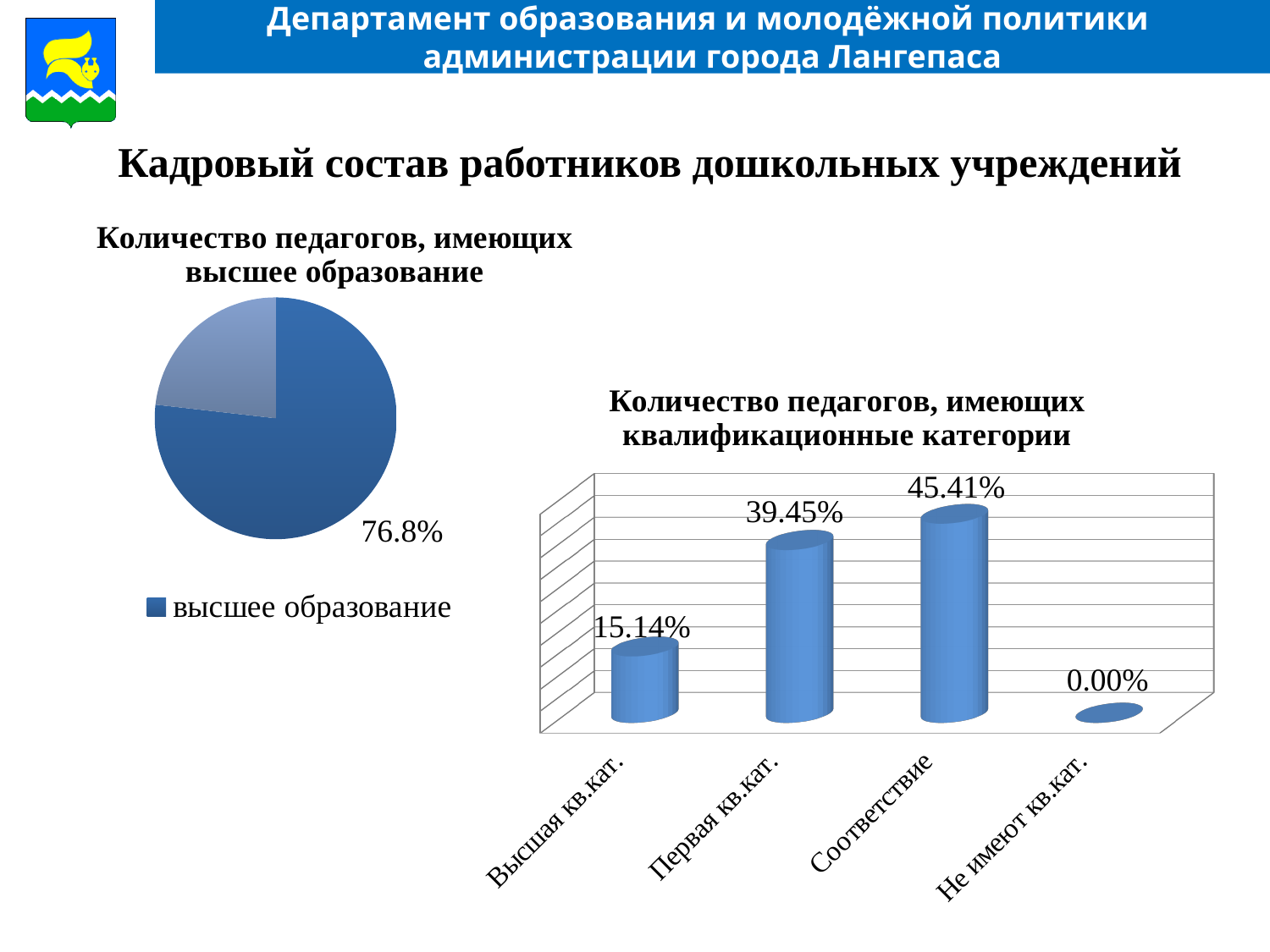
In the chart titled "Количество педагогов, имеющих квалификационные категории", which is larger: "Высшая кв.кат." or "Первая кв.кат."? Первая кв.кат. In the chart titled "Количество педагогов, имеющих квалификационные категории", what is the value for "Не имеют кв.кат."? 0.00% What kind of chart is the one titled "Количество педагогов, имеющих квалификационные категории"? Bar chart In the chart titled "Количество педагогов, имеющих квалификационные категории", what is the difference between the values for "Соответствие" and "Первая кв.кат."? 5.96% In the pie chart titled "Количество педагогов, имеющих высшее образование", what share is labelled for "высшее образование"? 76.8% In the chart titled "Количество педагогов, имеющих квалификационные категории", what is the value for "Высшая кв.кат."? 15.14% In the chart titled "Количество педагогов, имеющих квалификационные категории", which category has the highest value? Соответствие What kind of chart is the one titled "Количество педагогов, имеющих высшее образование"? Pie chart In the chart titled "Количество педагогов, имеющих квалификационные категории", which category has the lowest value? Не имеют кв.кат. How many categories are shown in the chart titled "Количество педагогов, имеющих квалификационные категории"? 4 In the chart titled "Количество педагогов, имеющих квалификационные категории", what is the value for "Соответствие"? 45.41% In the chart titled "Количество педагогов, имеющих квалификационные категории", what is the value for "Первая кв.кат."? 39.45%